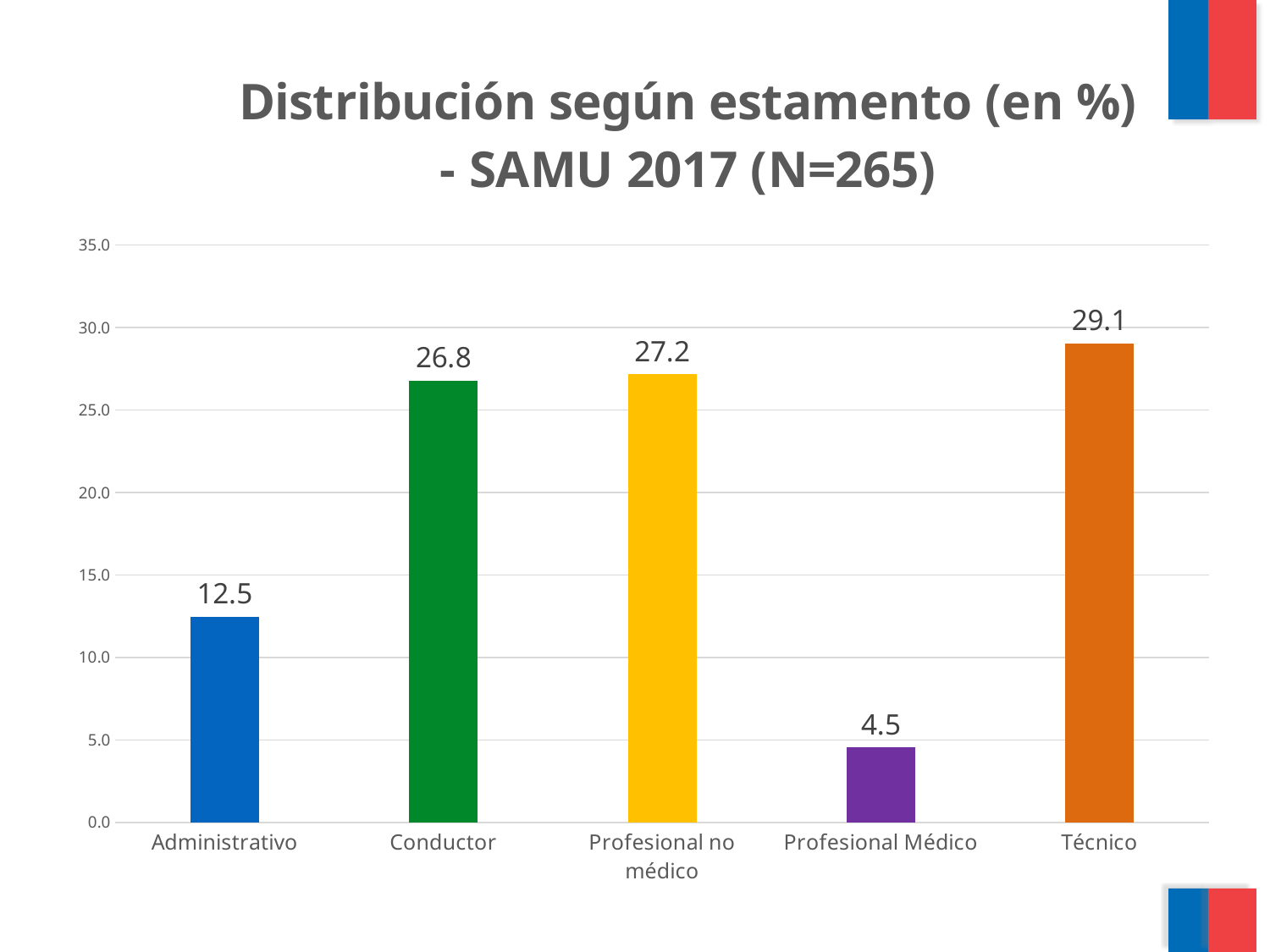
What kind of chart is shown on the slide? bar chart Which category has the lowest value? Profesional Médico What is the difference between the values for Profesional no médico and Profesional Médico? 22.7 What is the difference between the values for Técnico and Administrativo? 16.6 Which is larger, the value for Técnico or the value for Conductor? Técnico Is the value for Administrativo greater or less than 15.0? less What is the value for Profesional Médico? 4.5 What is the value for Conductor? 26.8 How many categories are shown on the x axis? 5 Which category has the highest value? Técnico What is the title of the chart? Distribución según estamento (en %) - SAMU 2017 (N=265) What is the value for Administrativo? 12.5